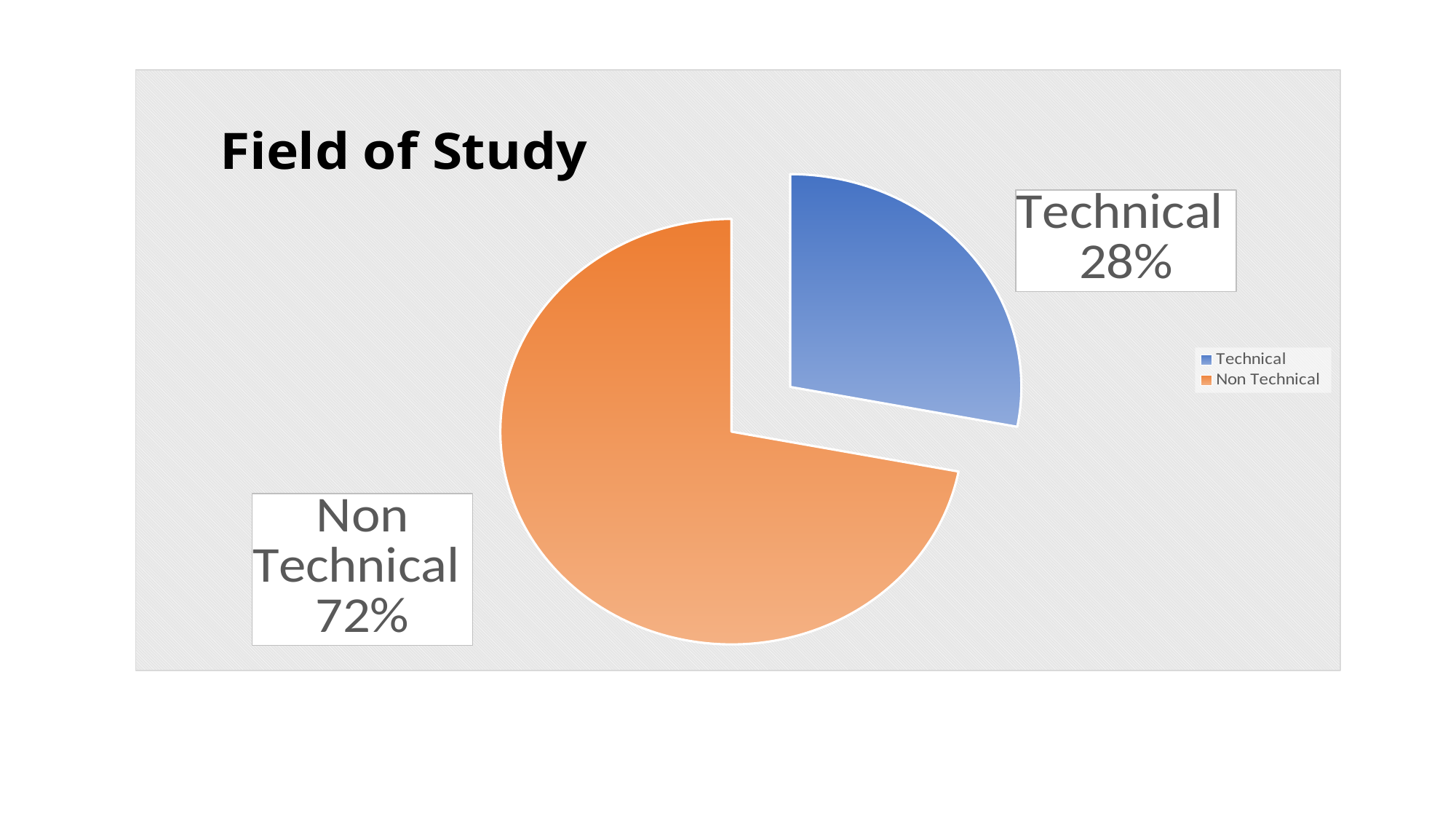
How many entries does the legend list? 2 What percentage of the pie is Non Technical? 72% Which slice is the largest? Non Technical What kind of chart is shown on the slide? pie chart How many slices does the pie chart have? 2 What share of the pie does the Non Technical slice represent? 72% What is the difference in percentage points between Non Technical and Technical? 44 Which is larger, Technical or Non Technical? Non Technical What percentage of the pie is Technical? 28% What is the title of the chart? Field of Study What colour is the Technical slice? blue Which slice is the smallest? Technical